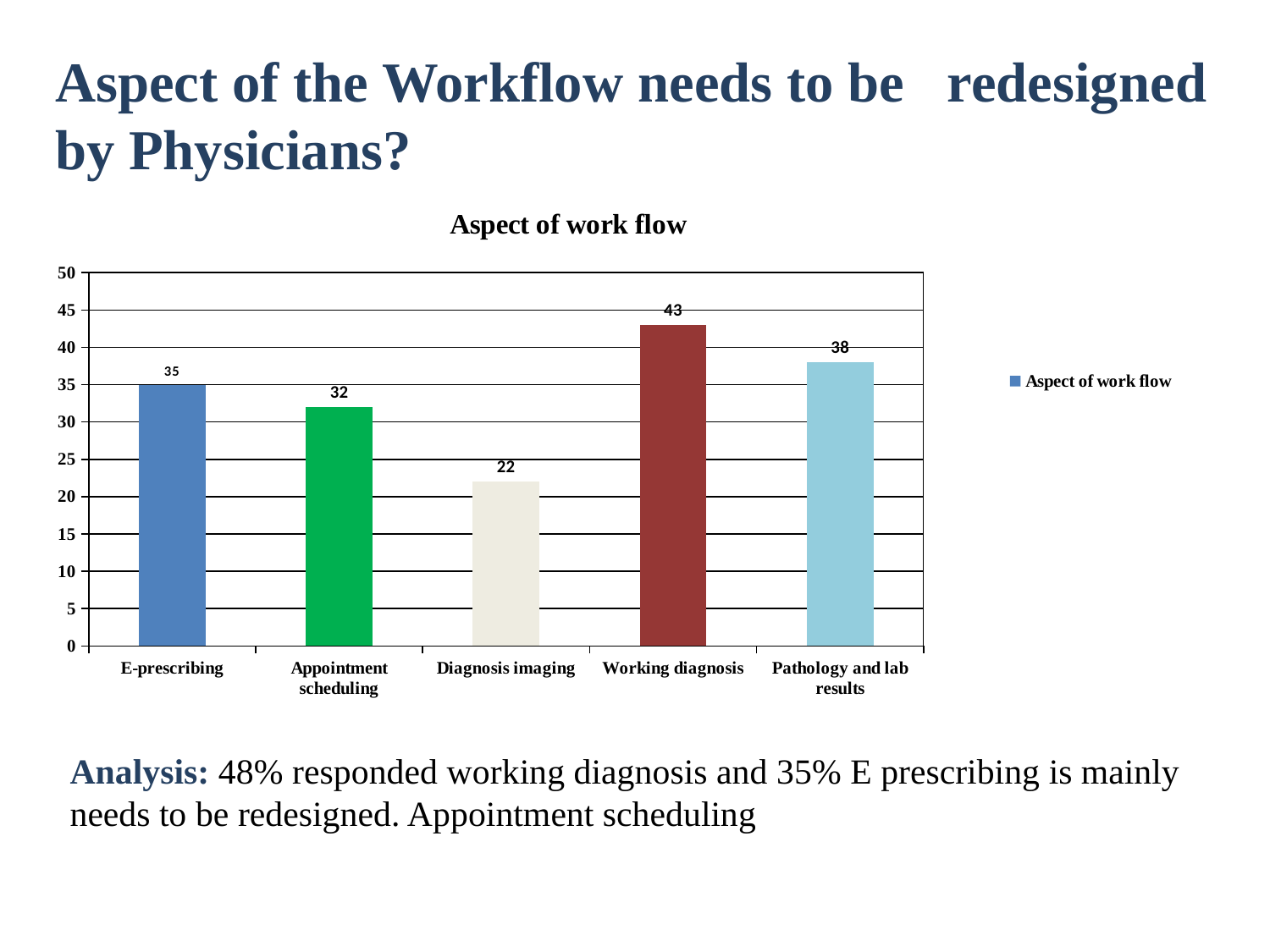
Is the value for Appointment scheduling greater or less than 30? greater What is the value for Pathology and lab results? 38 What is the difference between the values for Working diagnosis and Diagnosis imaging? 21 How many categories are shown on the x axis? 5 Which is larger, the value for Pathology and lab results or the value for E-prescribing? Pathology and lab results What is the value for Diagnosis imaging? 22 Which category has the lowest value? Diagnosis imaging What is the value for Working diagnosis? 43 Which category has the highest value? Working diagnosis What is the title of the chart? Aspect of work flow What is the difference between the values for E-prescribing and Appointment scheduling? 3 What kind of chart is shown on the slide? bar chart